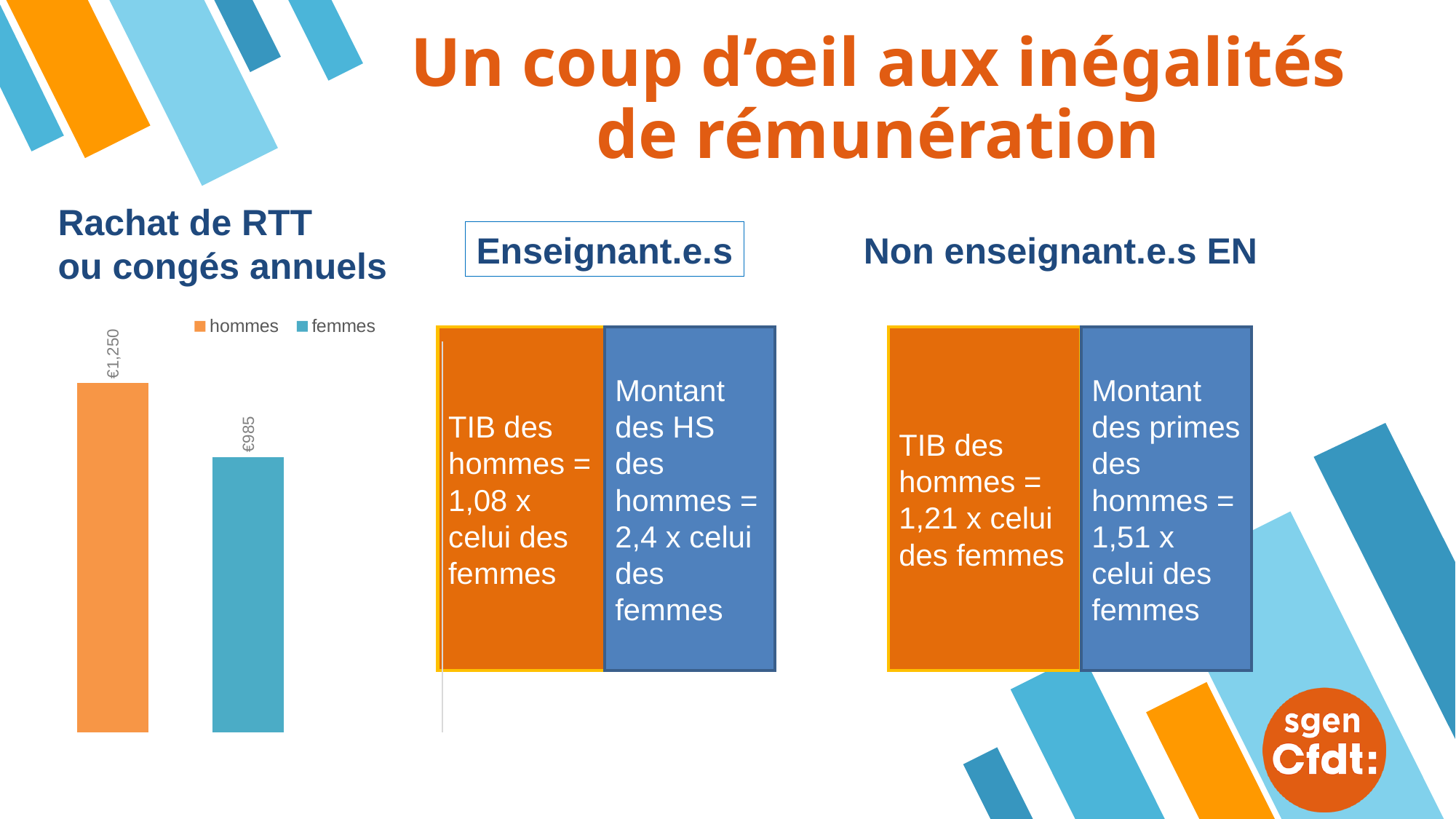
How many series does the chart legend list? 2 How many bars are plotted in the chart? 2 What is the difference between the hommes value and the femmes value in the bar chart? €265 What is the value for hommes in the bar chart? €1,250 Which bar is higher in the chart, hommes or femmes? hommes Which bar is lower in the chart, hommes or femmes? femmes Is the value for hommes larger or smaller than the value for femmes in the bar chart? larger What kind of chart is shown on the slide? bar chart What colour is the hommes bar in the chart? orange What is the value for femmes in the bar chart? €985 What are the two entries in the chart legend? hommes, femmes